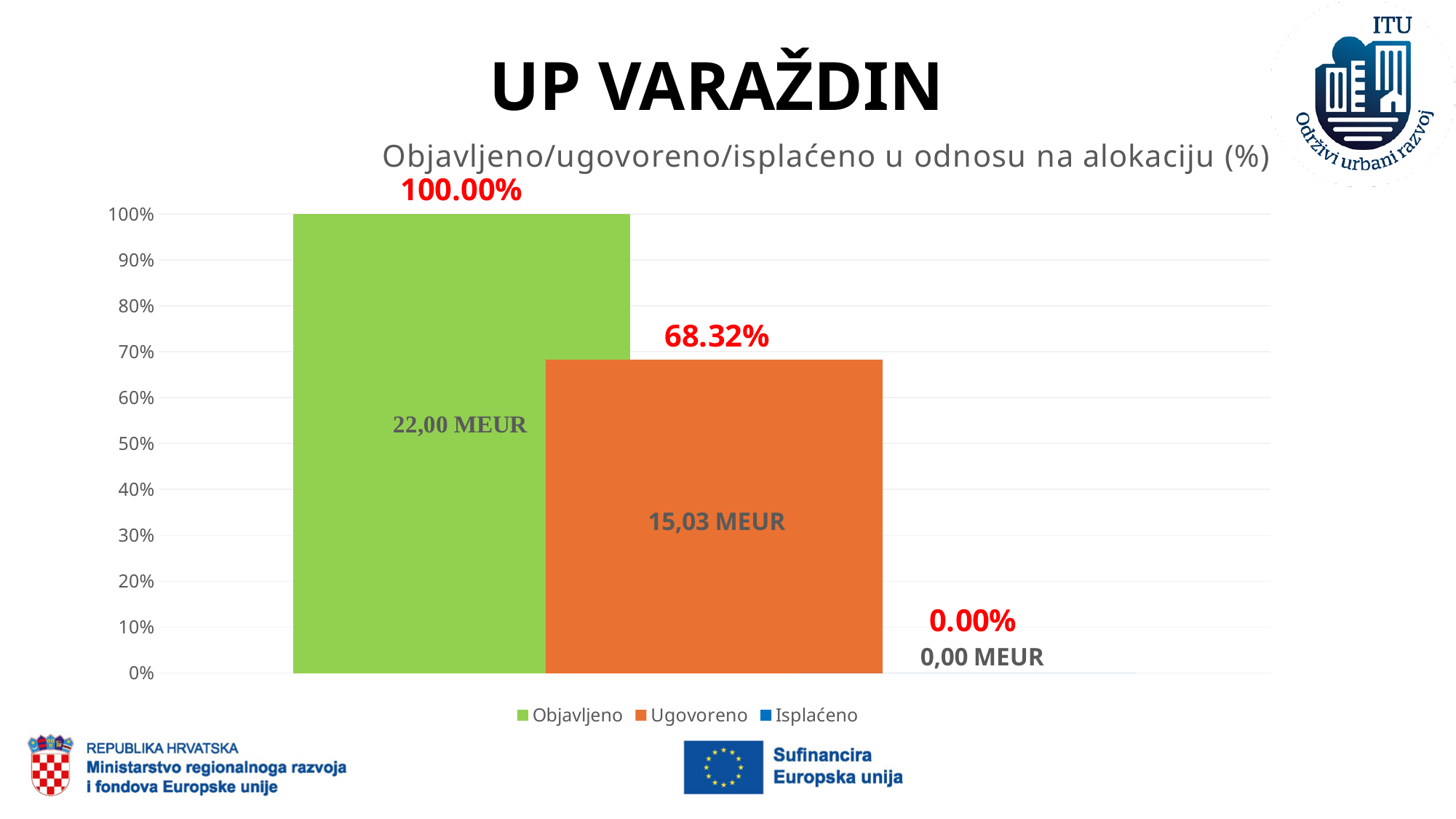
What percentage value is shown for Isplaćeno? 0.00% Which series has the highest percentage value? Objavljeno What percentage value is shown for Objavljeno? 100.00% What amount in MEUR is labelled on the Ugovoreno bar? 15,03 MEUR Which is larger, the value for Ugovoreno or the value for Isplaćeno? Ugovoreno What is the difference in percentage points between Objavljeno and Ugovoreno? 31.68 What amount in MEUR is labelled on the Objavljeno bar? 22,00 MEUR What is the title of the chart? Objavljeno/ugovoreno/isplaćeno u odnosu na alokaciju (%) What kind of chart is shown on the slide? Bar chart What percentage value is shown for Ugovoreno? 68.32% How many series does the legend list? 3 Which series has the lowest percentage value? Isplaćeno